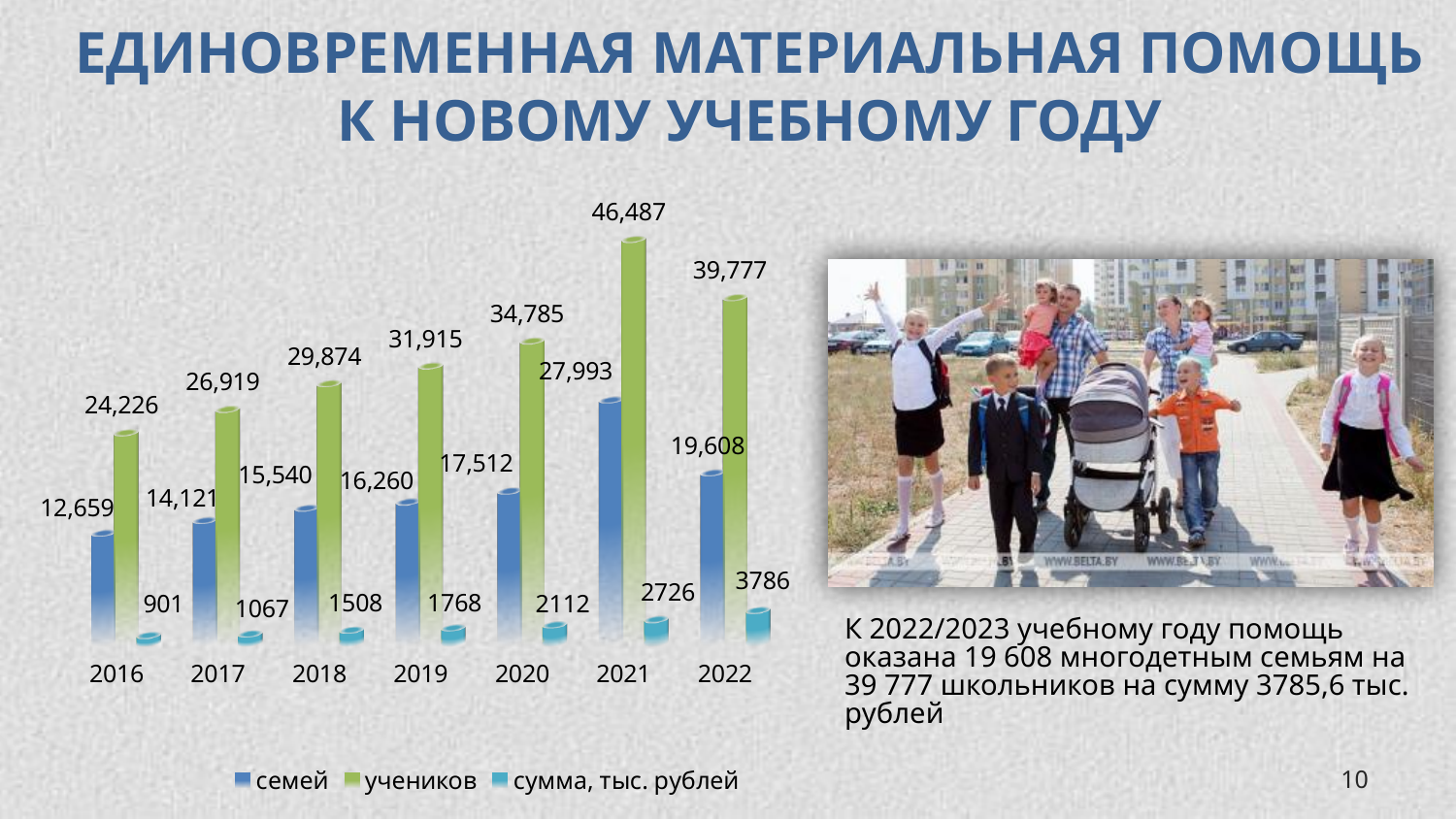
Which colour represents the семей series in the chart? blue How many series does the chart legend list? 3 How many years are shown on the x axis of the chart? 7 What is the value for сумма, тыс. рублей in 2022? 3786 In which year is the value for учеников the highest? 2021 In which year is the value for сумма, тыс. рублей the lowest? 2016 Which is larger: the семей value for 2021 or for 2022? 2021 What is the value for семей in 2016? 12,659 What type of chart is shown on the slide? bar chart Does the value for сумма, тыс. рублей rise or fall from 2016 to 2022? rise What is the difference between the учеников values for 2021 and 2022? 6,710 What is the value for учеников in 2021? 46,487